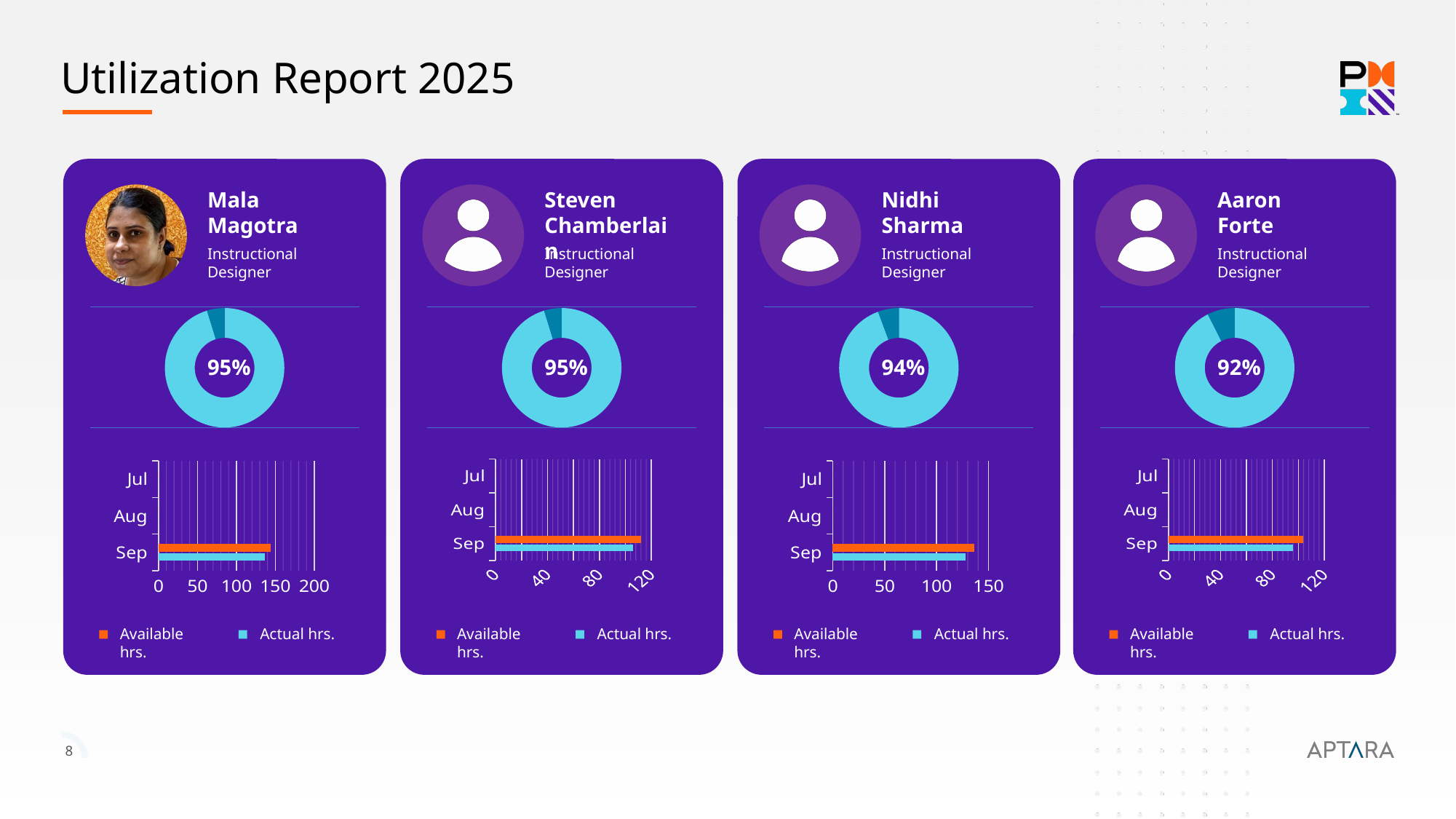
On Steven Chamberlain's bar chart, is the Sep value for Available hrs. greater or less than 80? greater On Nidhi Sharma's card, what percentage does the donut chart show? 94% On Mala Magotra's bar chart, which is larger for Sep: Available hrs. or Actual hrs.? Available hrs. On Aaron Forte's bar chart, is the Sep value for Actual hrs. greater or less than 80? greater On Aaron Forte's card, what percentage does the donut chart show? 92% How many months are listed on the y axis of Nidhi Sharma's bar chart? 3 Across the four donut charts, which person has the lowest percentage? Aaron Forte On Nidhi Sharma's bar chart, is the Sep value for Actual hrs. greater or less than 100? greater How many series does the legend list on Steven Chamberlain's bar chart? 2 On Mala Magotra's card, what percentage does the donut chart show? 95% What kind of chart is the monthly hours chart on Aaron Forte's card? Bar chart